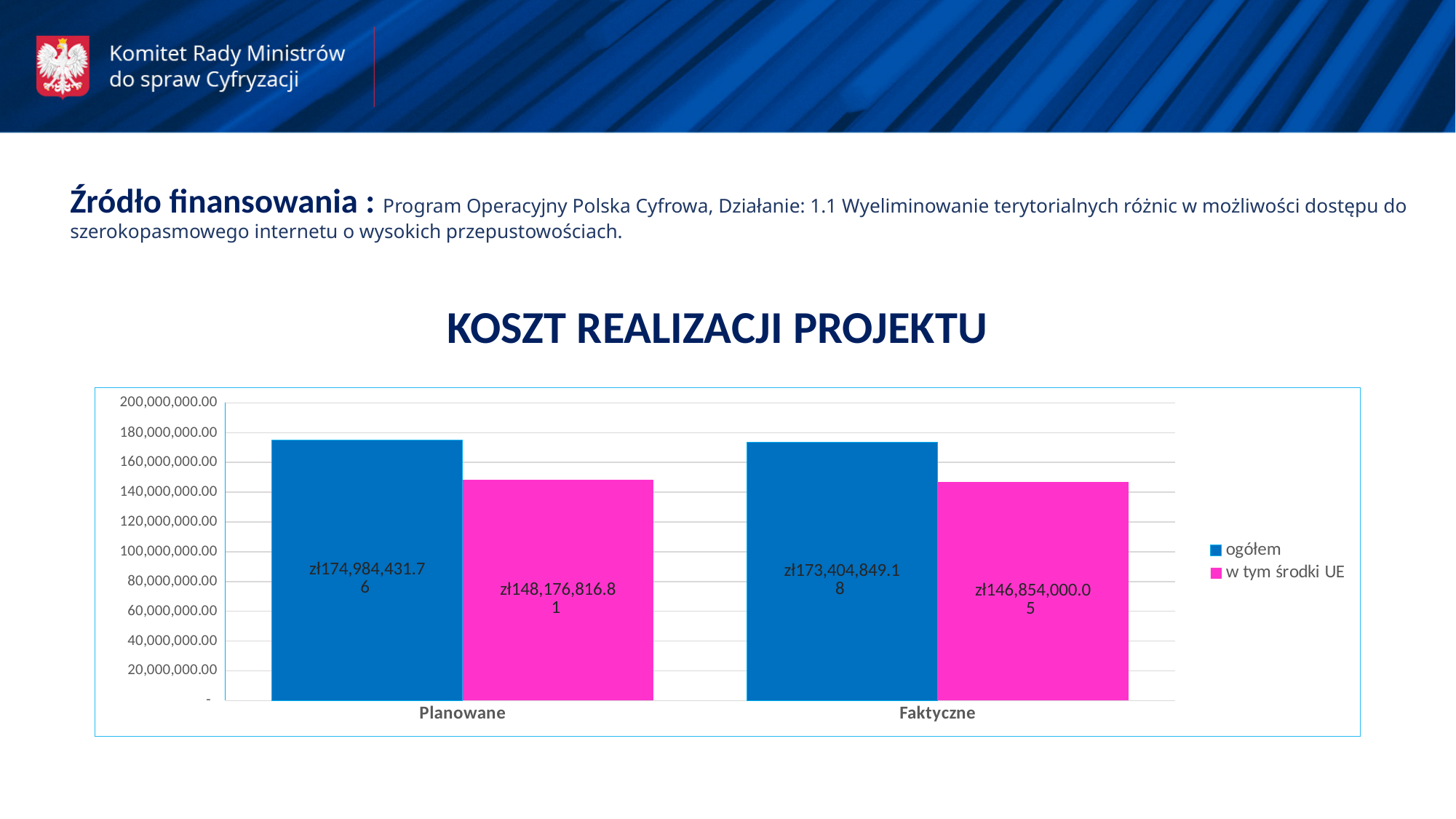
What is the title of the chart? KOSZT REALIZACJI PROJEKTU Which category has the higher ogółem value, Planowane or Faktyczne? Planowane What is the value of w tym środki UE for Planowane? zł148,176,816.81 What kind of chart is shown on the slide? bar chart How many categories are shown on the x axis? 2 What is the value of w tym środki UE for Faktyczne? zł146,854,000.05 How many series does the legend list? 2 What is the difference between ogółem and w tym środki UE for Faktyczne? zł26,550,849.13 What is the value of ogółem for Planowane? zł174,984,431.76 Is the value of w tym środki UE for Planowane greater or less than 140,000,000.00? greater What is the difference between the ogółem values for Planowane and Faktyczne? zł1,579,582.58 What is the value of ogółem for Faktyczne? zł173,404,849.18